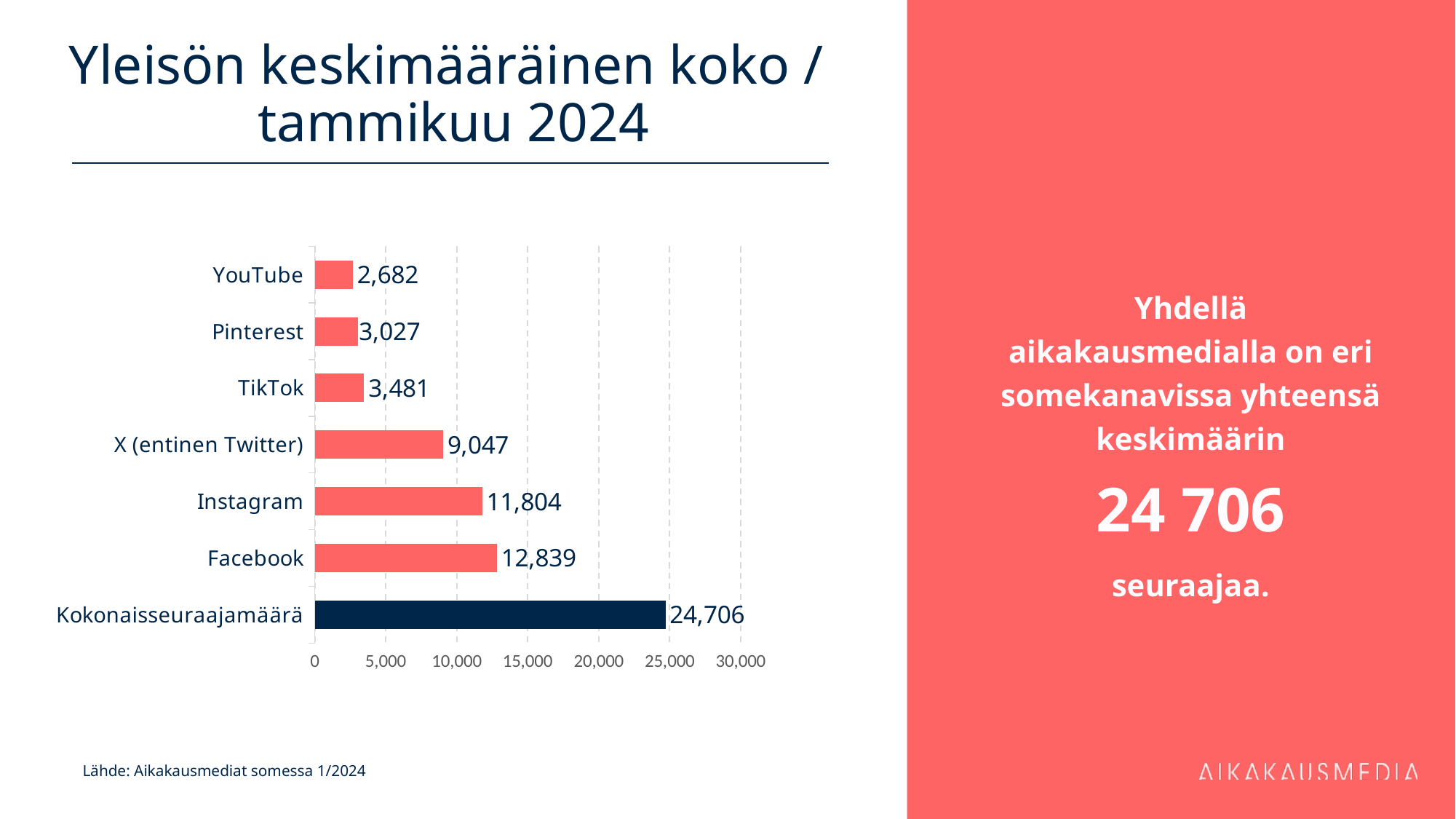
Is the value for Facebook greater or less than 10,000? greater Which bar is shown in a different colour (dark navy) from the others? Kokonaisseuraajamäärä Which is larger, the value for TikTok or the value for Pinterest? TikTok What is the value for X (entinen Twitter)? 9,047 What is the value for Kokonaisseuraajamäärä? 24,706 What is the difference between the values for Facebook and Instagram? 1,035 What kind of chart is shown on the slide? bar chart Which category has the lowest value? YouTube What is the difference between the values for X (entinen Twitter) and TikTok? 5,566 How many categories are shown in the chart? 7 What is the value for Instagram? 11,804 Which category has the highest value? Kokonaisseuraajamäärä